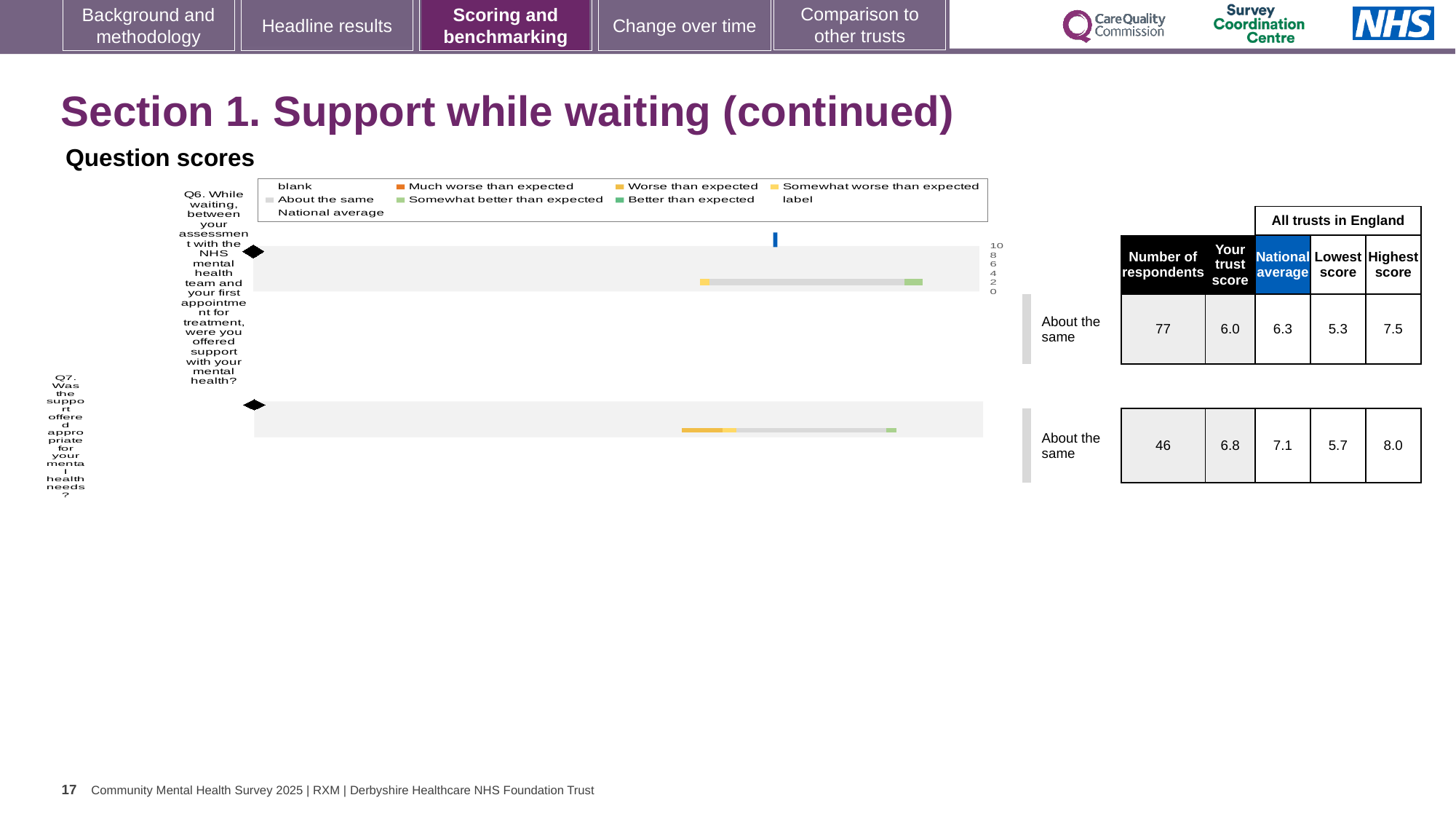
What is the highest score among all trusts in England for Q7? 8.0 What is the difference between the highest and lowest scores for Q7? 2.3 By how much does the national average exceed the trust score for Q6? 0.3 What is the 'Your trust score' for Q6 (support with mental health while waiting)? 6.0 What benchmarking category is shown for Q7? About the same How many respondents answered Q7 (was the support offered appropriate)? 46 Which question has more respondents, Q6 or Q7? Q6 What is the national average score for Q6? 6.3 What kind of chart is used to show the question scores on this slide? bar chart What is the lowest score among all trusts in England for Q6? 5.3 Which question has the higher 'Your trust score', Q6 or Q7? Q7 How many questions are plotted in the question scores chart? 2